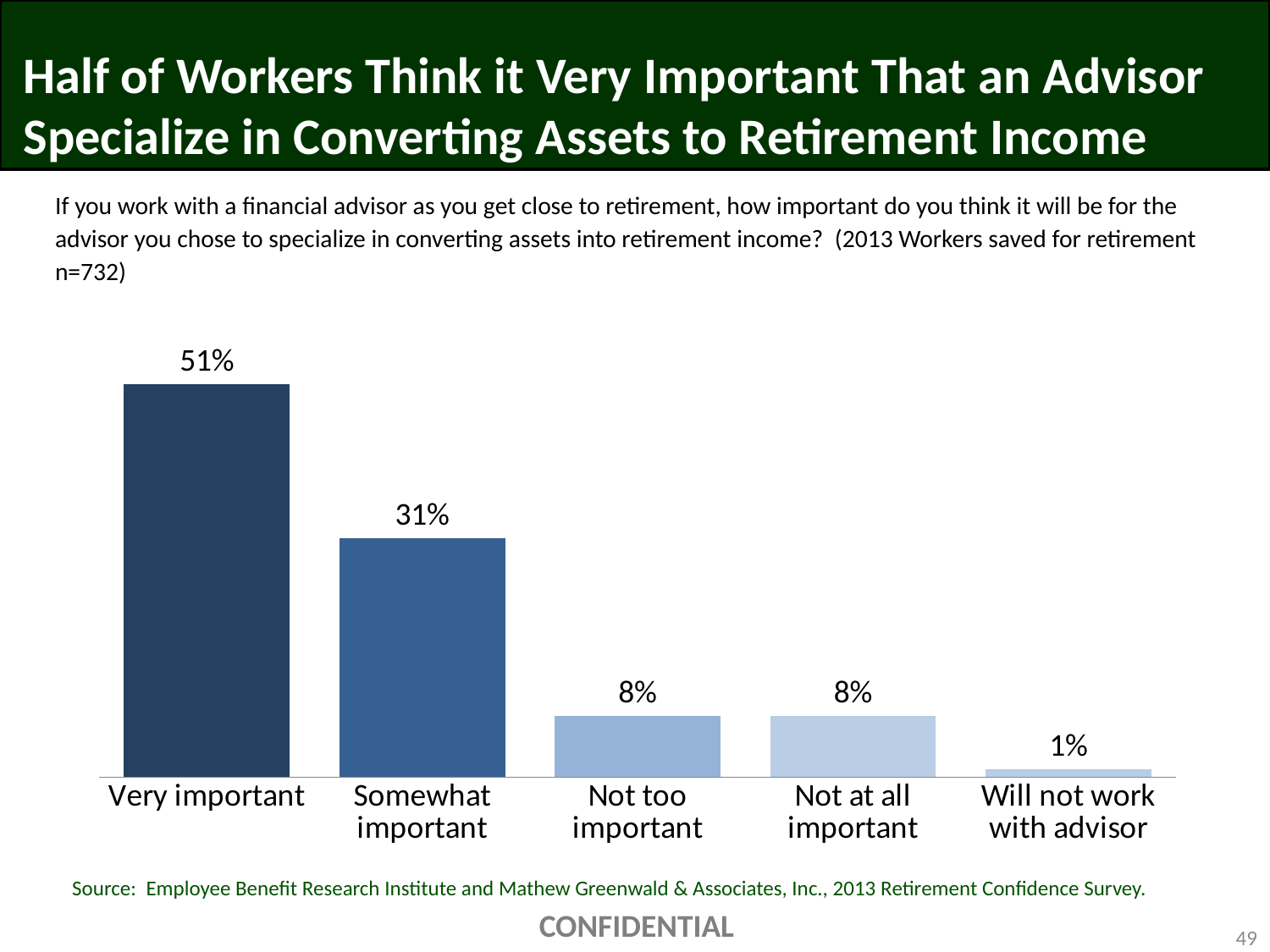
Which is larger, the value for 'Somewhat important' or the value for 'Not at all important'? Somewhat important What is the difference between the 'Very important' and 'Somewhat important' values? 20 percentage points What percentage of workers said it is very important that an advisor specialize in converting assets to retirement income? 51% What kind of chart is shown on the slide? Bar chart Do the values rise or fall moving from left to right across the categories? Fall Which category has the highest value? Very important What is the value for 'Not too important'? 8% What is the combined value of 'Very important' and 'Somewhat important'? 82% How many categories are shown on the chart? 5 What is the value for 'Will not work with advisor'? 1% What is the value for 'Somewhat important'? 31% Which category has the lowest value? Will not work with advisor